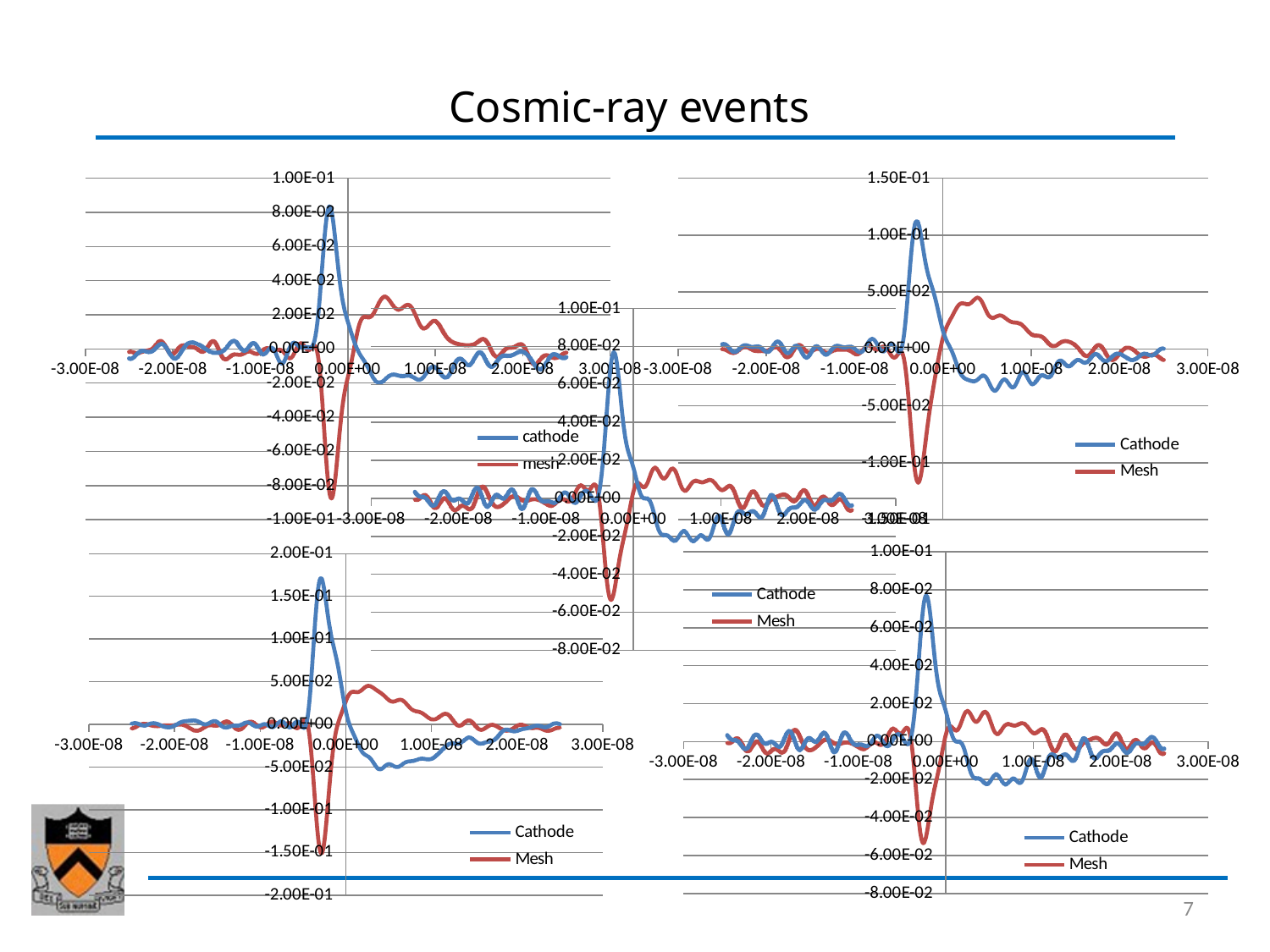
In the top-left chart, is the minimum value of the mesh series greater or less than -6.00E-02? less In the center chart, is the minimum value of the Mesh series greater or less than -4.00E-02? less In the top-right chart, is the minimum value of the Mesh series greater or less than -5.00E-02? less What are the legend entries of the bottom-left chart? Cathode, Mesh In the bottom-left chart, which series reaches the higher maximum value, Cathode or Mesh? Cathode How many series does the legend of the top-left chart list? 2 In the top-right chart, which series reaches the higher maximum value, Cathode or Mesh? Cathode What kind of chart is the top-left chart on the slide? line chart How many charts are shown on the slide? 5